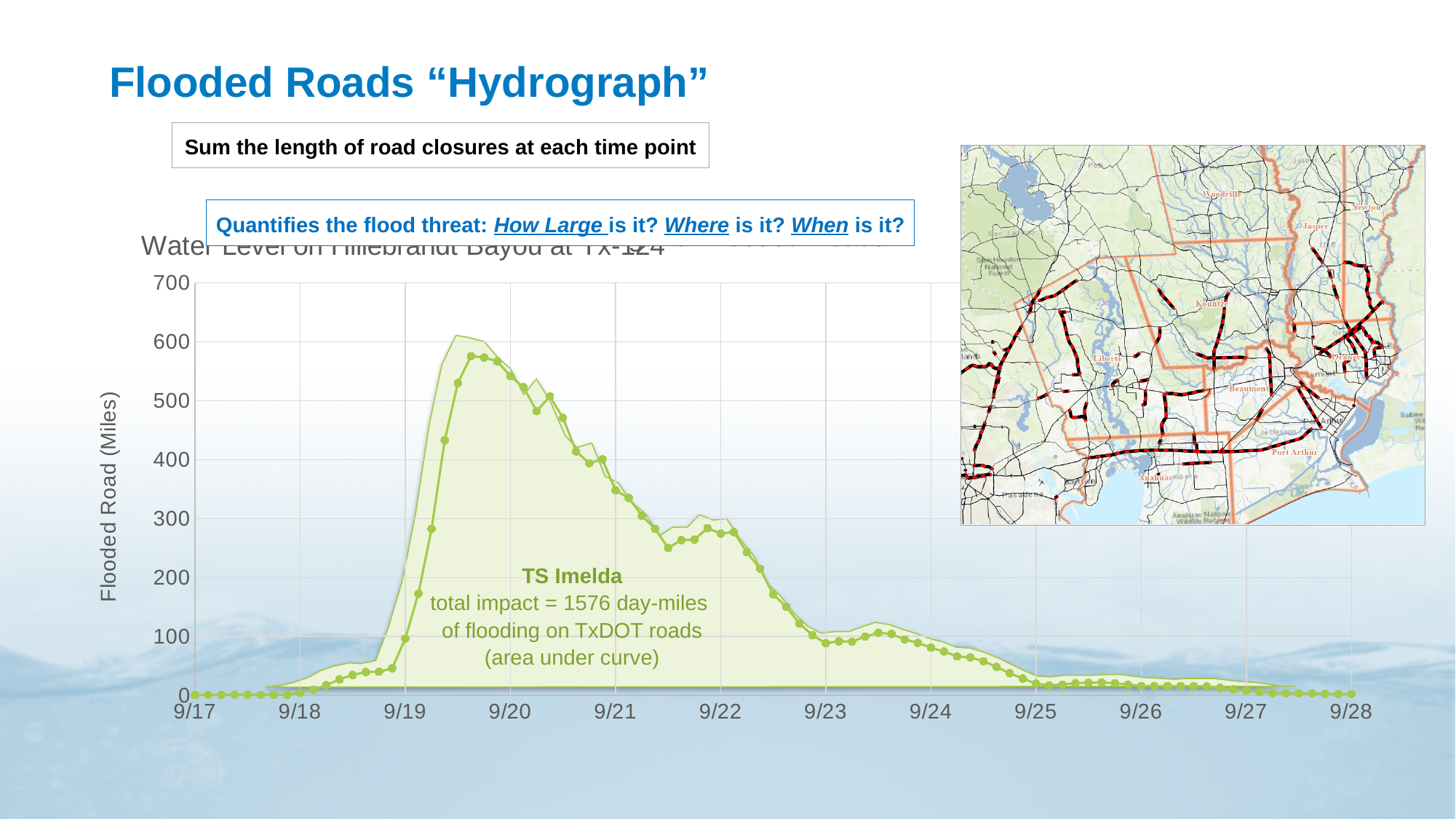
Between which two labeled dates does the flooded road mileage reach its peak? 9/19 and 9/20 Is the value for 9/25 greater or less than 100? less How many dates are labeled along the x axis of the chart? 12 Do the flooded road values rise or fall between 9/20 and 9/23? fall Is the value for 9/22 greater or less than 200? greater What total impact, in day-miles, is stated in the annotation on the chart? 1576 day-miles What is the label on the vertical axis of the chart? Flooded Road (Miles) Which storm is named in the annotation on the chart? TS Imelda Is the value for 9/20 greater or less than 500? greater What kind of chart is shown on the slide? line chart Which date has the larger flooded road mileage, 9/20 or 9/22? 9/20